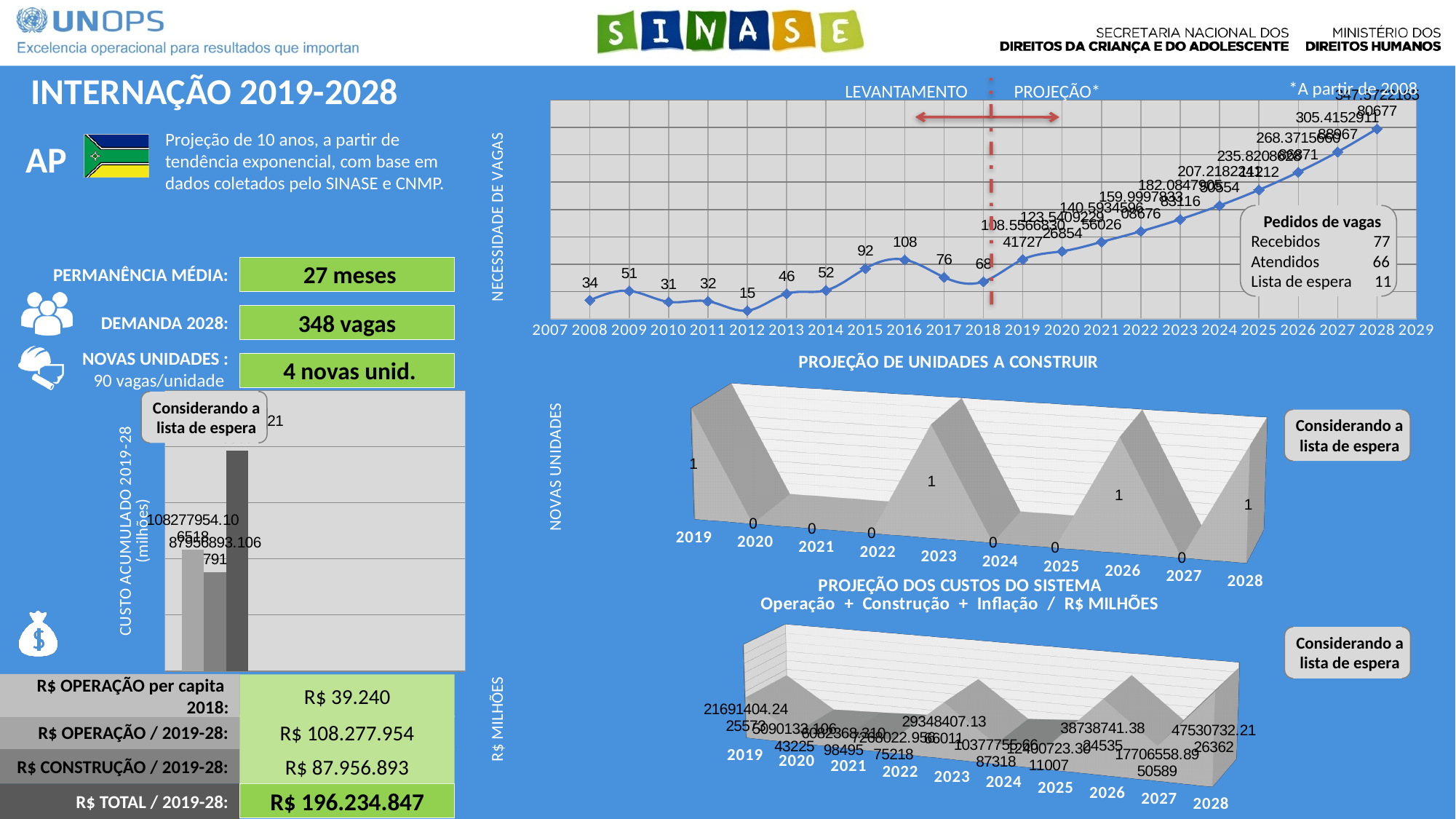
In the line chart 'NECESSIDADE DE VAGAS', which year between 2008 and 2018 has the highest value? 2016 In the line chart 'NECESSIDADE DE VAGAS', do the values rise or fall from 2018 to 2028? rise In the chart 'PROJEÇÃO DE UNIDADES A CONSTRUIR', what is the value for 2024? 0 In the line chart 'NECESSIDADE DE VAGAS', which year between 2008 and 2018 has the lowest value? 2012 In the line chart 'NECESSIDADE DE VAGAS', what is the value for 2018? 68 In the chart 'PROJEÇÃO DE UNIDADES A CONSTRUIR', how many years are shown on the x axis? 10 In the line chart 'NECESSIDADE DE VAGAS', what is the value for 2012? 15 In the chart 'PROJEÇÃO DE UNIDADES A CONSTRUIR', what is the value for 2019? 1 In the line chart 'NECESSIDADE DE VAGAS', which is larger, the value for 2014 or the value for 2015? 2015 In the line chart 'NECESSIDADE DE VAGAS', what is the difference between the values for 2016 and 2017? 32 What kind of chart is 'NECESSIDADE DE VAGAS' at the top right of the slide? line chart In the line chart 'NECESSIDADE DE VAGAS', what is the value for 2016? 108